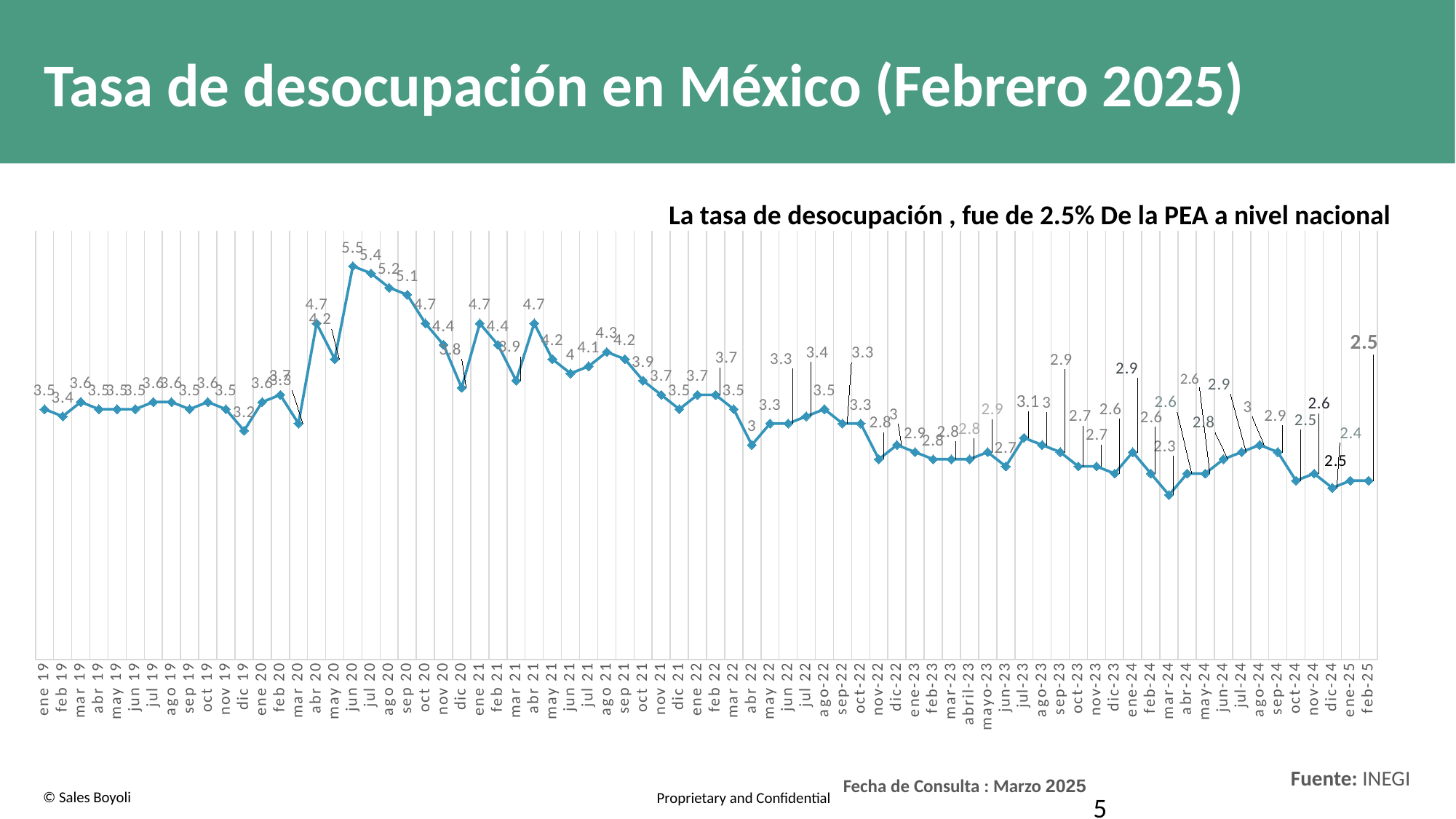
Which month has the highest unemployment rate in the chart? jun 20 What is the value plotted for dic 19? 3.2 What type of chart is shown on the slide? line chart What is the unemployment rate (tasa de desocupación) for feb-25? 2.5 Which is larger, the value for abr 20 or the value for may 20? abr 20 What is the title of the slide containing the chart? Tasa de desocupación en México (Febrero 2025) Which month has the lowest unemployment rate in the chart? mar-24 Overall, does the unemployment rate rise or fall from jun 20 to feb-25? fall What is the value plotted for jun 20? 5.5 What is the value plotted for mar-24? 2.3 What is the difference between the highest value (jun 20) and the lowest value (mar-24)? 3.2 By how much did the rate fall from ene 19 (3.5) to feb-25 (2.5)? 1